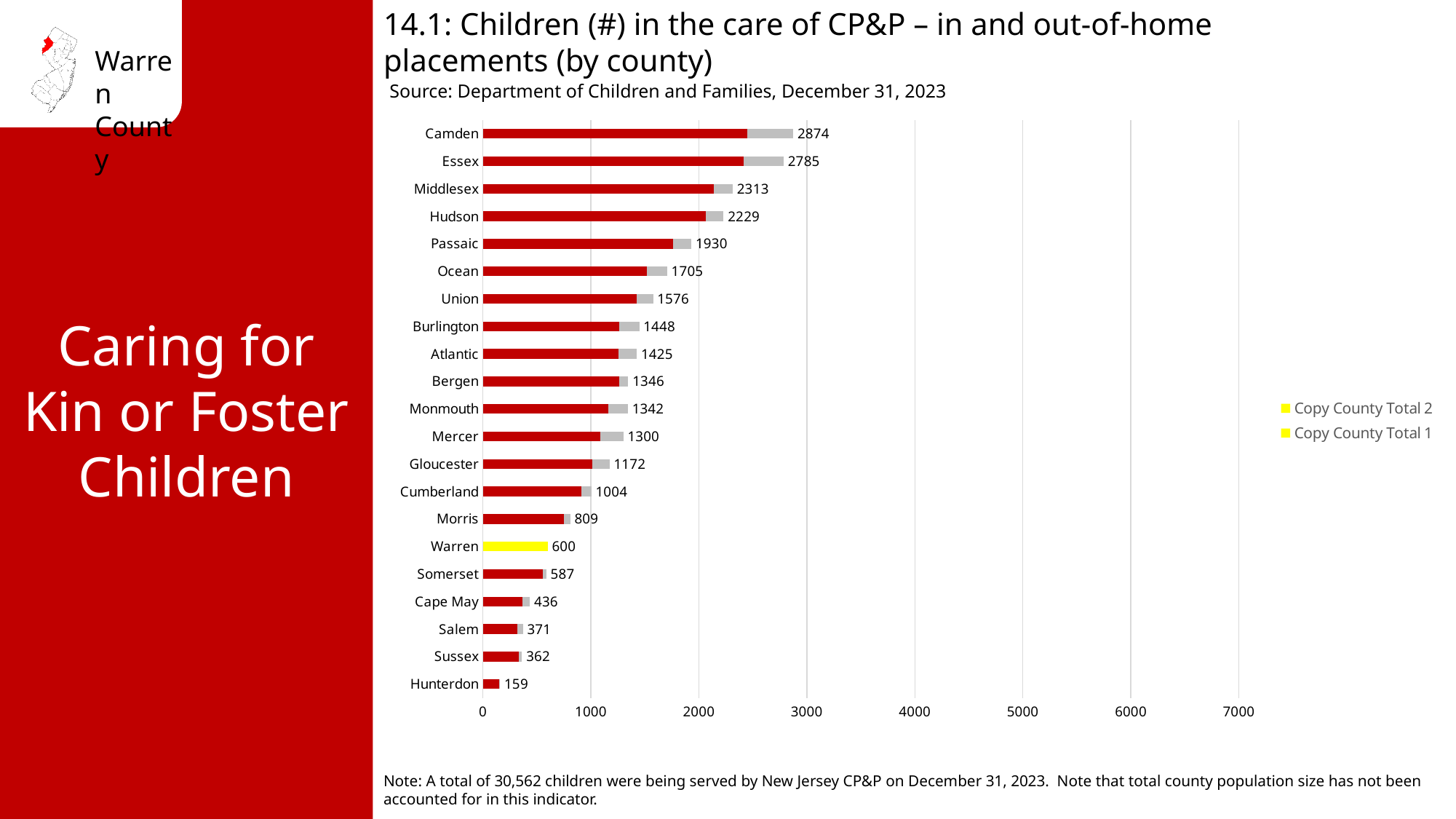
What is the difference between the values for Camden and Essex? 89 What is the value shown for Hunterdon? 159 Which has a larger value, Ocean or Union? Ocean How many counties are shown on the chart? 21 Is the value for Passaic greater or less than 2000? less What is the value shown for Camden? 2874 Which county has the lowest value? Hunterdon What kind of chart is shown on the slide? bar chart How many series does the legend list? 2 What is the value shown for Warren? 600 Which county has the highest value? Camden What is the difference between the values for Warren and Somerset? 13